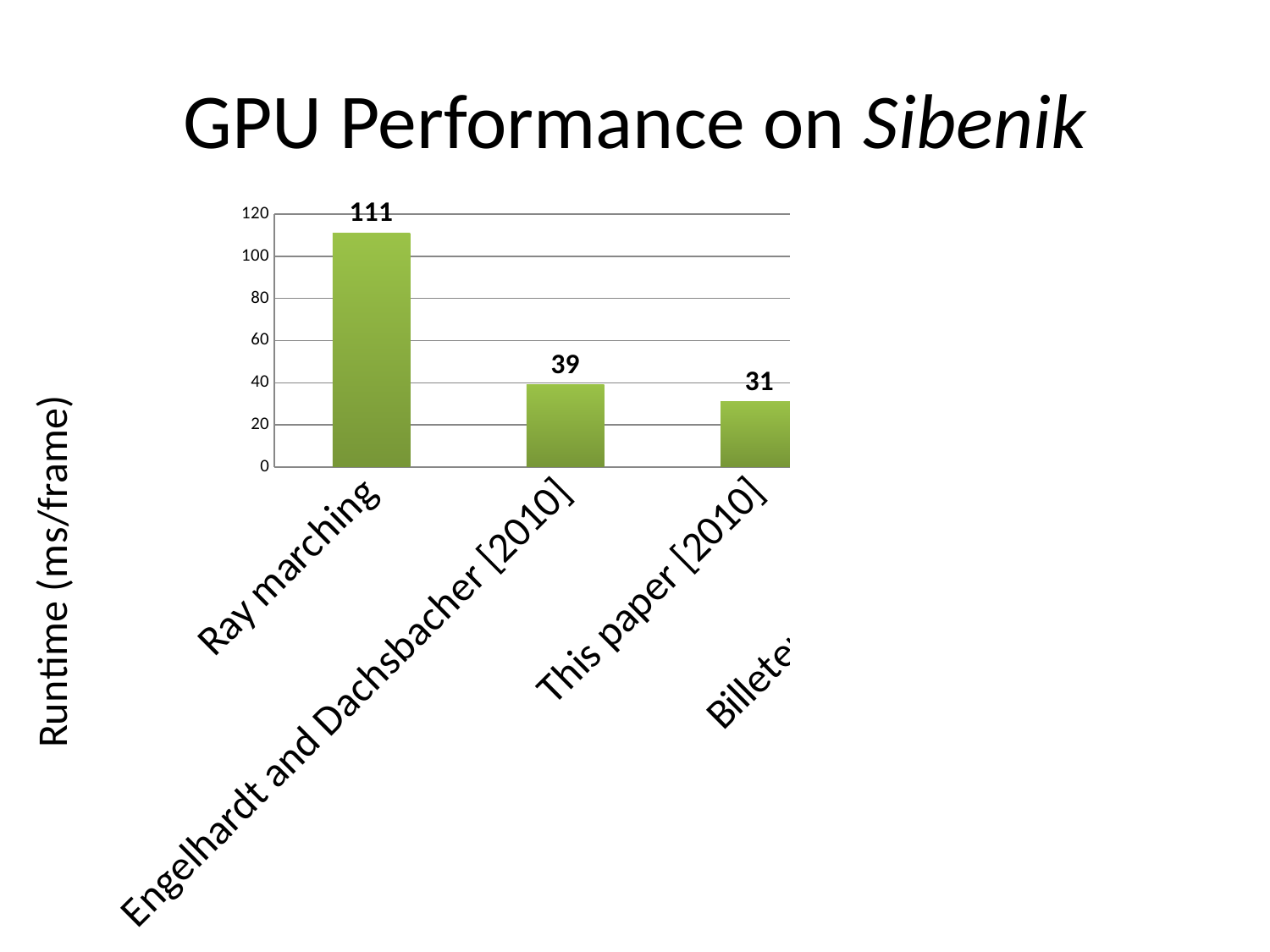
Which has a larger runtime, Ray marching or Engelhardt and Dachsbacher [2010]? Ray marching Which category has the highest runtime? Ray marching What is the runtime value for Engelhardt and Dachsbacher [2010]? 39 What is the title of the chart on the slide? GPU Performance on Sibenik What kind of chart is shown on the slide? Bar chart Which of the labelled bars has the lowest runtime? This paper [2010] What is the runtime value for Ray marching? 111 What is the label of the vertical axis? Runtime (ms/frame) What is the difference in runtime between Ray marching and This paper [2010]? 80 What is the difference in runtime between Engelhardt and Dachsbacher [2010] and This paper [2010]? 8 Is the value for Ray marching greater or less than 100? greater What is the runtime value for This paper [2010]? 31